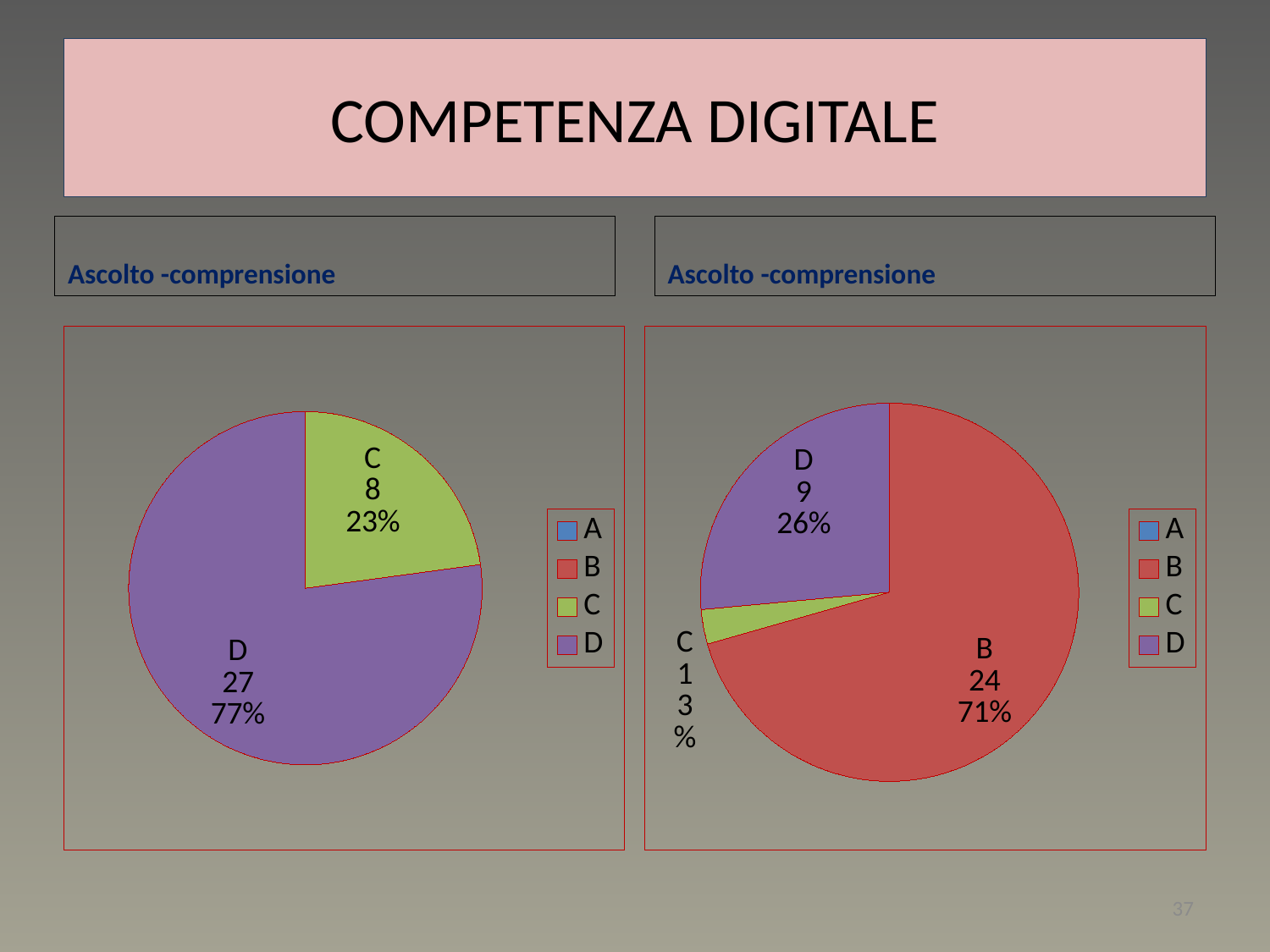
How many slices with data labels does the left pie chart have? 2 In the right pie chart, what is the value for category B? 24 How many entries does the legend of the right chart list? 4 In the left pie chart, what percentage share does category C have? 23% In the right pie chart, which category has the largest slice? B What type of chart is shown on the left of the slide? Pie chart In the left pie chart, what is the difference between the values for D and C? 19 In the right pie chart, what percentage share does category D have? 26% In the right pie chart, which is larger, the value for D or the value for B? B In the left pie chart, what is the value for category D? 27 In the right pie chart, which category has the smallest slice? C In the right pie chart, what is the value for category C? 1